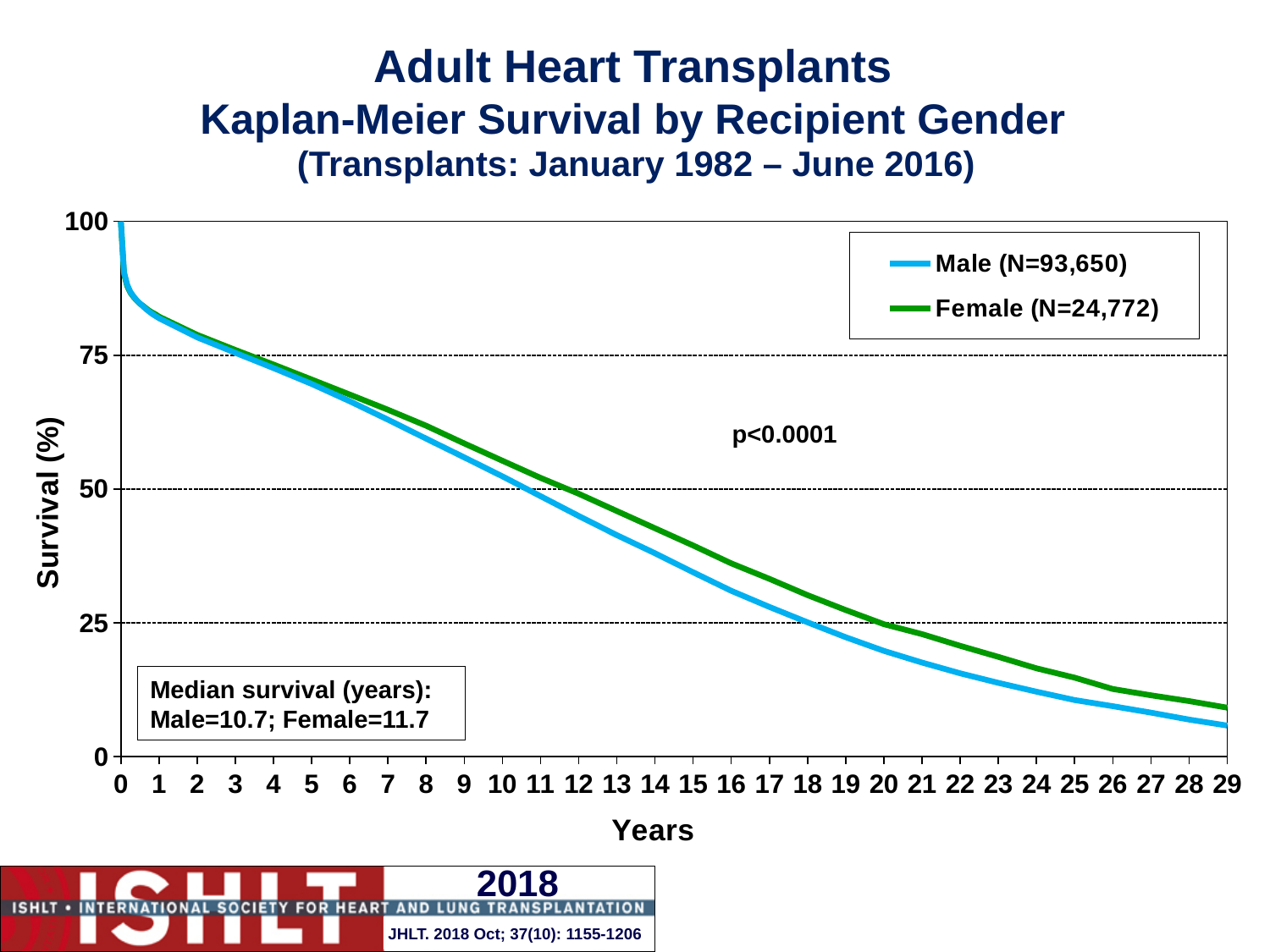
Do the survival curves rise or fall as years increase? fall What is the number of Male recipients (N) shown in the legend? 93,650 How many series does the legend list? 2 Is the survival value for Male at 20 years greater or less than 25? less Is the survival value for Male at 15 years greater or less than 25? greater At 15 years, which series has the higher survival, Male or Female? Female What kind of chart is shown on the slide? line chart Is the survival value for Female at 25 years greater or less than 25? less At 20 years, which series has the lower survival, Male or Female? Male What is the median survival in years for Female recipients according to the text box? 11.7